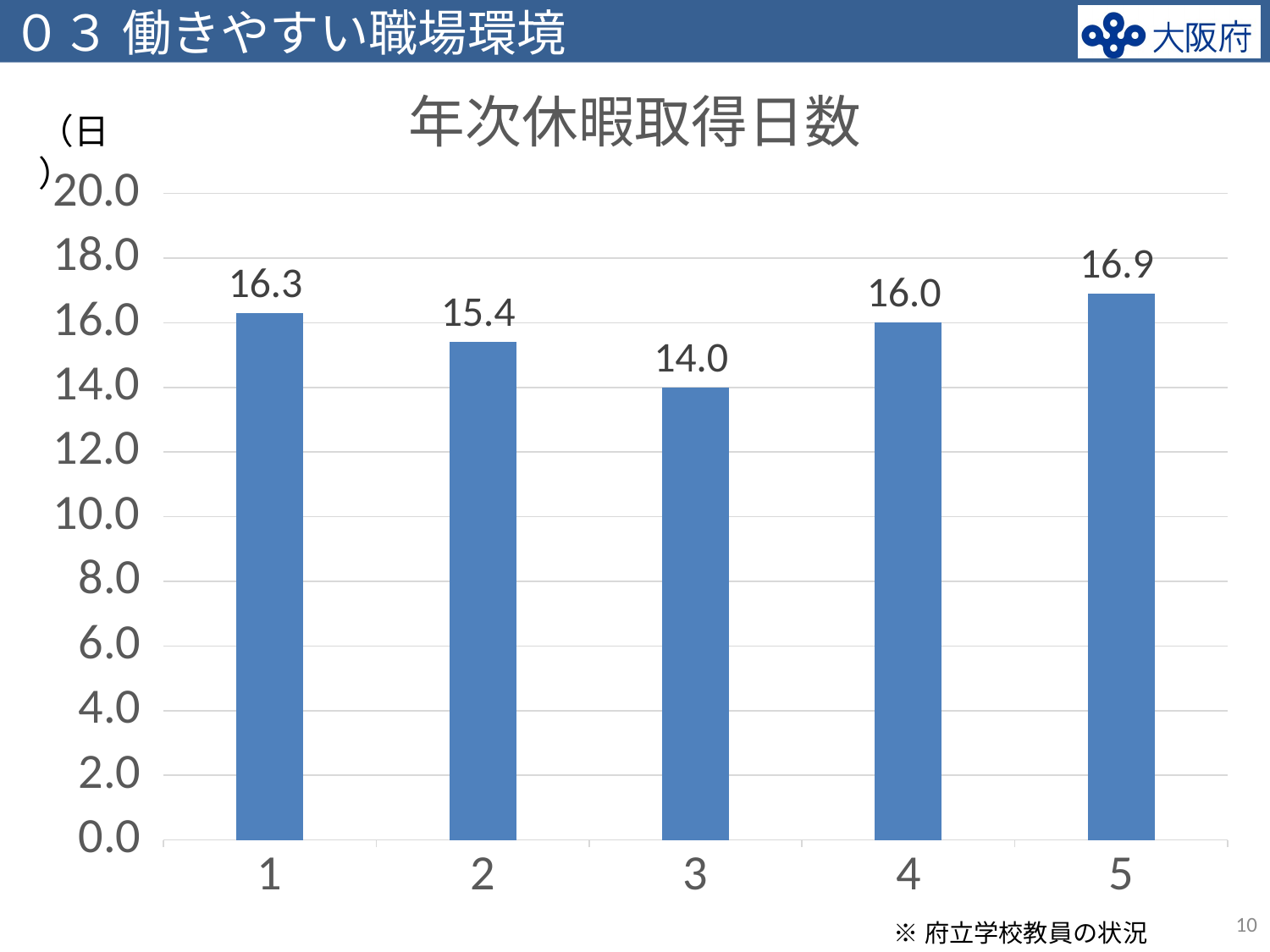
What kind of chart is shown on the slide? bar chart What is the value for category 1? 16.3 What is the difference between the values for category 1 and category 2? 0.9 Is the value for category 3 greater or less than 16.0? less How many bars are shown in the chart? 5 What is the difference between the values for category 5 and category 3? 2.9 What is the value for category 5? 16.9 Which category has the lowest value? 3 What is the value for category 3? 14.0 Which is larger, the value for category 2 or the value for category 4? 4 Which category has the highest value? 5 What is the title of the chart? 年次休暇取得日数